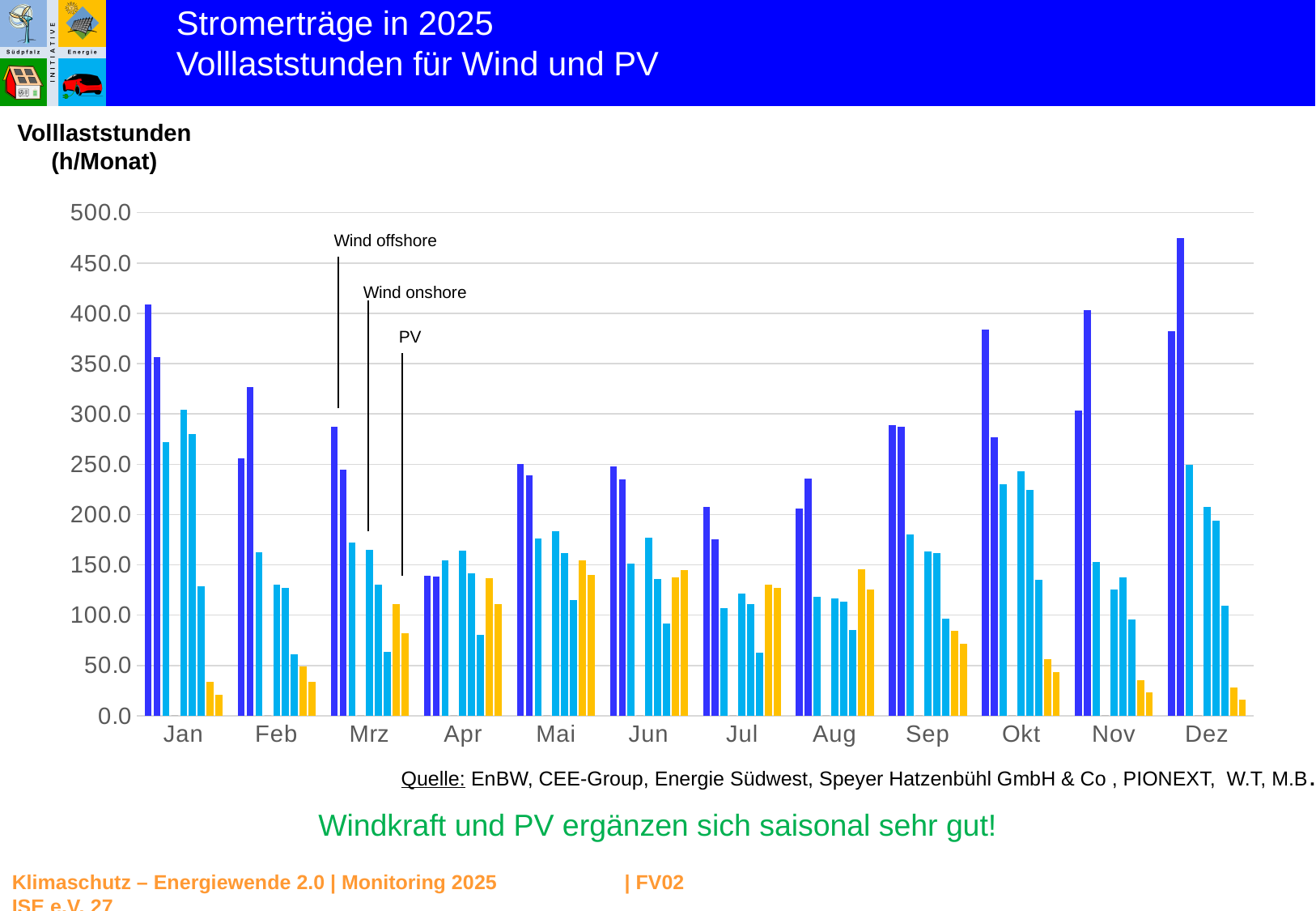
What kind of chart is shown on the slide? bar chart Do the PV values rise or fall from Aug to Dez? fall Is the tallest Wind offshore bar in Jan greater or less than 350? greater Is the tallest Wind offshore bar in Dez greater or less than 450? greater How many series are labelled in the chart? 3 How many months are shown along the x axis of the chart? 12 Are the PV bars in Dez greater or less than 50? less Which month has the taller Wind offshore bars, Jul or Dez? Dez What is the y-axis label of the chart? Volllaststunden (h/Monat) In which month does the tallest bar of the whole chart appear? Dez Which three series are labelled in the chart? Wind offshore, Wind onshore, PV